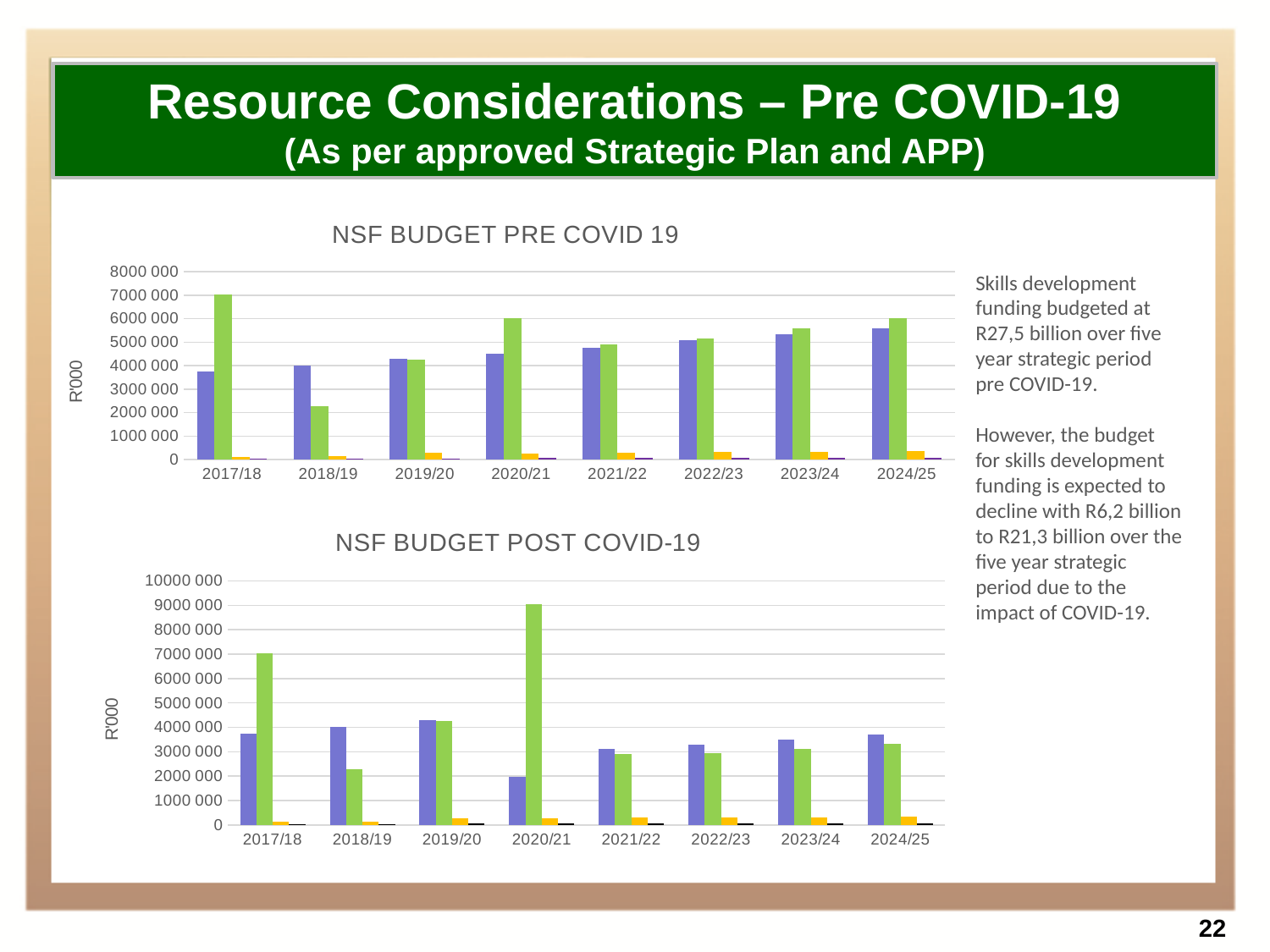
In the NSF BUDGET PRE COVID 19 chart, which financial year has the shortest green bar? 2018/19 In the NSF BUDGET POST COVID-19 chart, is the green bar for 2020/21 greater or less than 8000 000? greater In the NSF BUDGET PRE COVID 19 chart, do the blue bars rise or fall from 2017/18 to 2024/25? rise In the NSF BUDGET POST COVID-19 chart, is the blue bar for 2020/21 greater or less than 3000 000? less What kind of chart is the NSF BUDGET PRE COVID 19 chart? bar chart In the NSF BUDGET PRE COVID 19 chart, for 2017/18, which is larger: the blue bar or the green bar? the green bar In the NSF BUDGET PRE COVID 19 chart, which financial year has the tallest green bar? 2017/18 What unit label is shown on the vertical axis of the NSF BUDGET POST COVID-19 chart? R'000 In the NSF BUDGET PRE COVID 19 chart, is the green bar for 2018/19 greater or less than 3000 000? less In the NSF BUDGET POST COVID-19 chart, which financial year has the tallest green bar? 2020/21 How many financial-year categories are shown on the x axis of the NSF BUDGET POST COVID-19 chart? 8